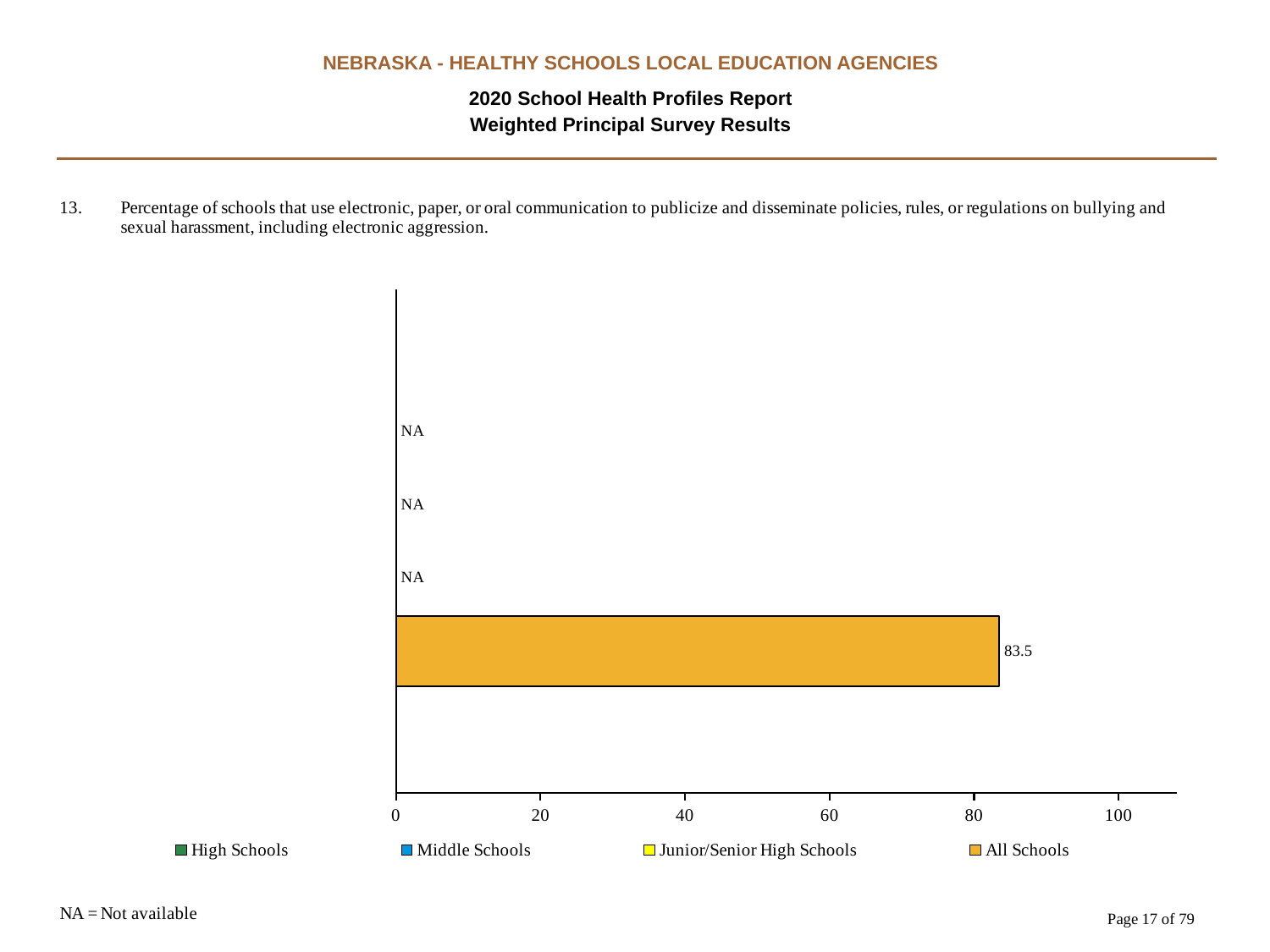
How many series have a plotted bar with a numeric value? 1 What is the highest tick value shown on the x axis? 100 How many series does the legend list? 4 Is the value for All Schools greater or less than 100? less Is the value for All Schools greater or less than 80? greater What value is shown for Middle Schools? NA What value is shown for High Schools? NA According to the note on the slide, what does NA stand for? Not available What kind of chart is shown on the slide? Bar chart What is the value for All Schools? 83.5 What value is shown for Junior/Senior High Schools? NA Which series is the only one with a numeric value shown? All Schools